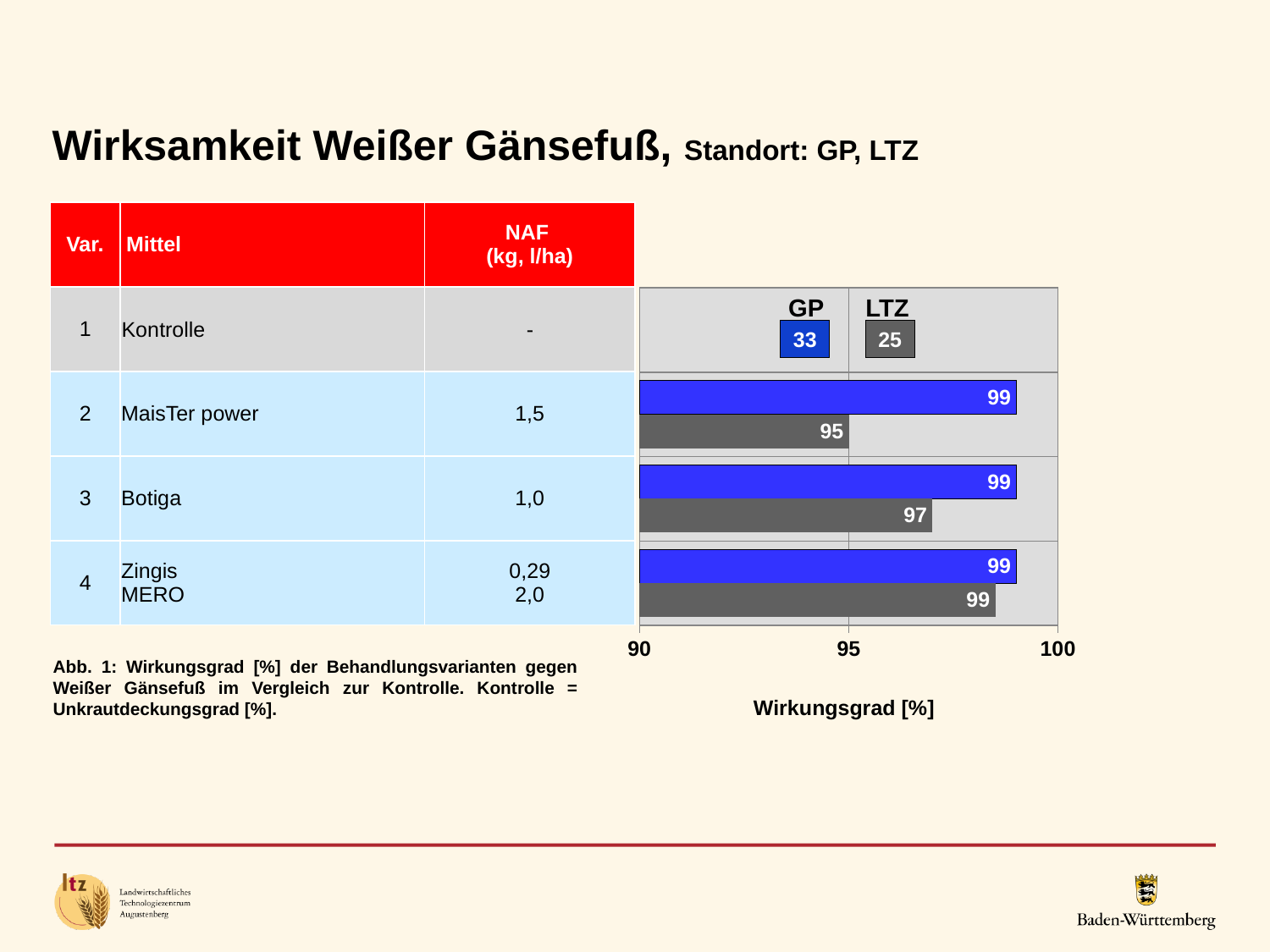
How many series does the chart legend list? 2 What is the difference between the GP and LTZ values for MaisTer power? 4 What is the difference between the LTZ values for Botiga and MaisTer power? 2 What is the label of the x axis of the chart? Wirkungsgrad [%] Which treatment has the lowest LTZ value? MaisTer power What is the LTZ value for MaisTer power? 95 Which is larger for Botiga, the GP value or the LTZ value? GP What is the LTZ value for Botiga? 97 What is the GP value for MaisTer power? 99 What value is shown for the Kontrolle at LTZ in the chart legend box? 25 What is the LTZ value for Zingis + MERO? 99 What kind of chart is shown on the slide? Bar chart